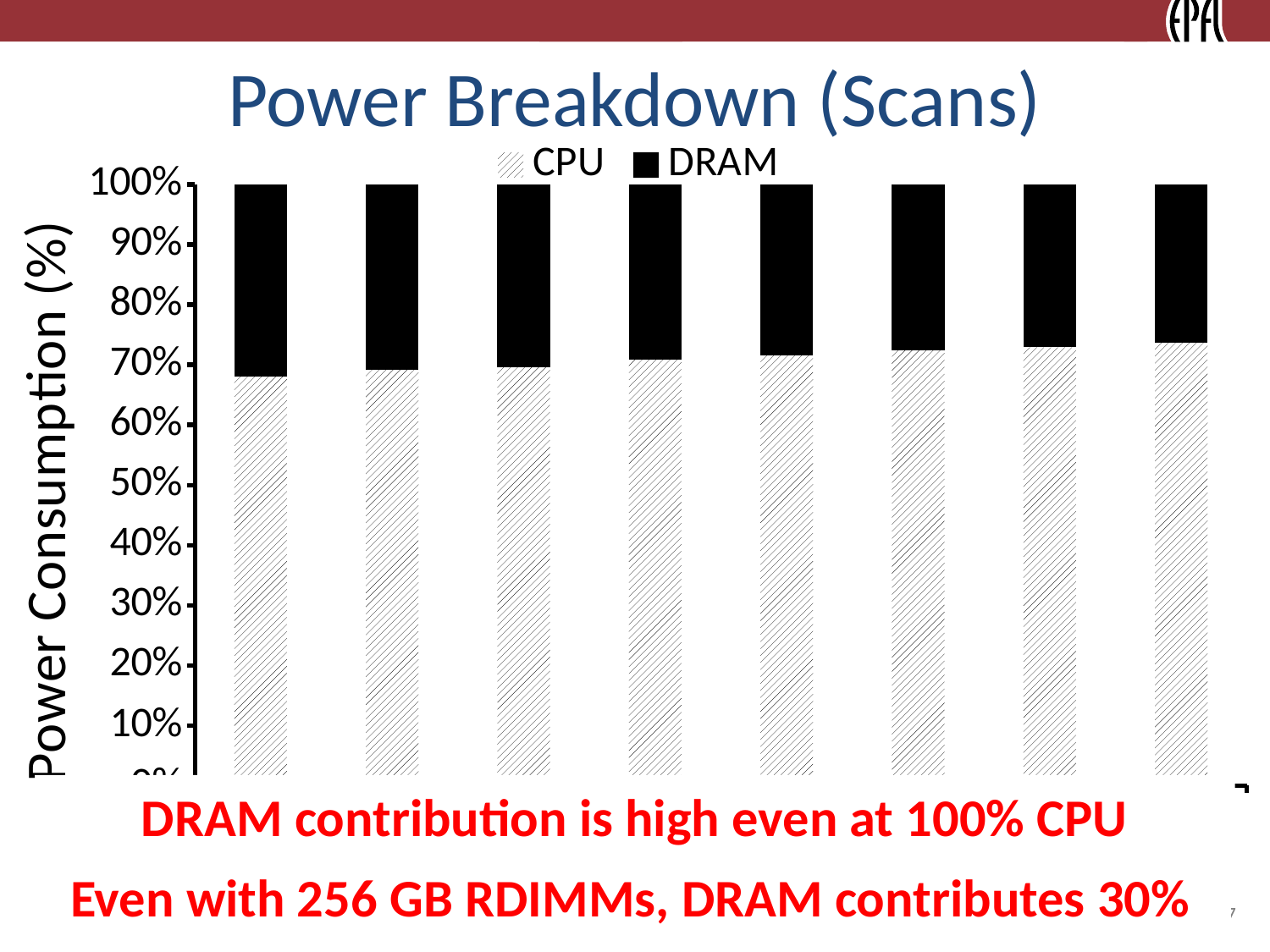
What are the two series named in the legend? CPU and DRAM Is the CPU share in the leftmost bar greater or less than 70%? less How many series does the legend list? 2 What is the label of the vertical axis? Power Consumption (%) What kind of chart is shown on the slide? stacked bar chart What is the title of the chart on the slide? Power Breakdown (Scans) Is the DRAM share in the leftmost bar greater or less than 30%? greater How many bars are plotted in the chart? 8 Does the DRAM share rise or fall moving from the leftmost bar to the rightmost bar? fall Is the CPU share in the rightmost bar greater or less than 70%? greater Does the CPU share rise or fall moving from the leftmost bar to the rightmost bar? rise Which bar has the largest DRAM share, the leftmost or the rightmost? leftmost